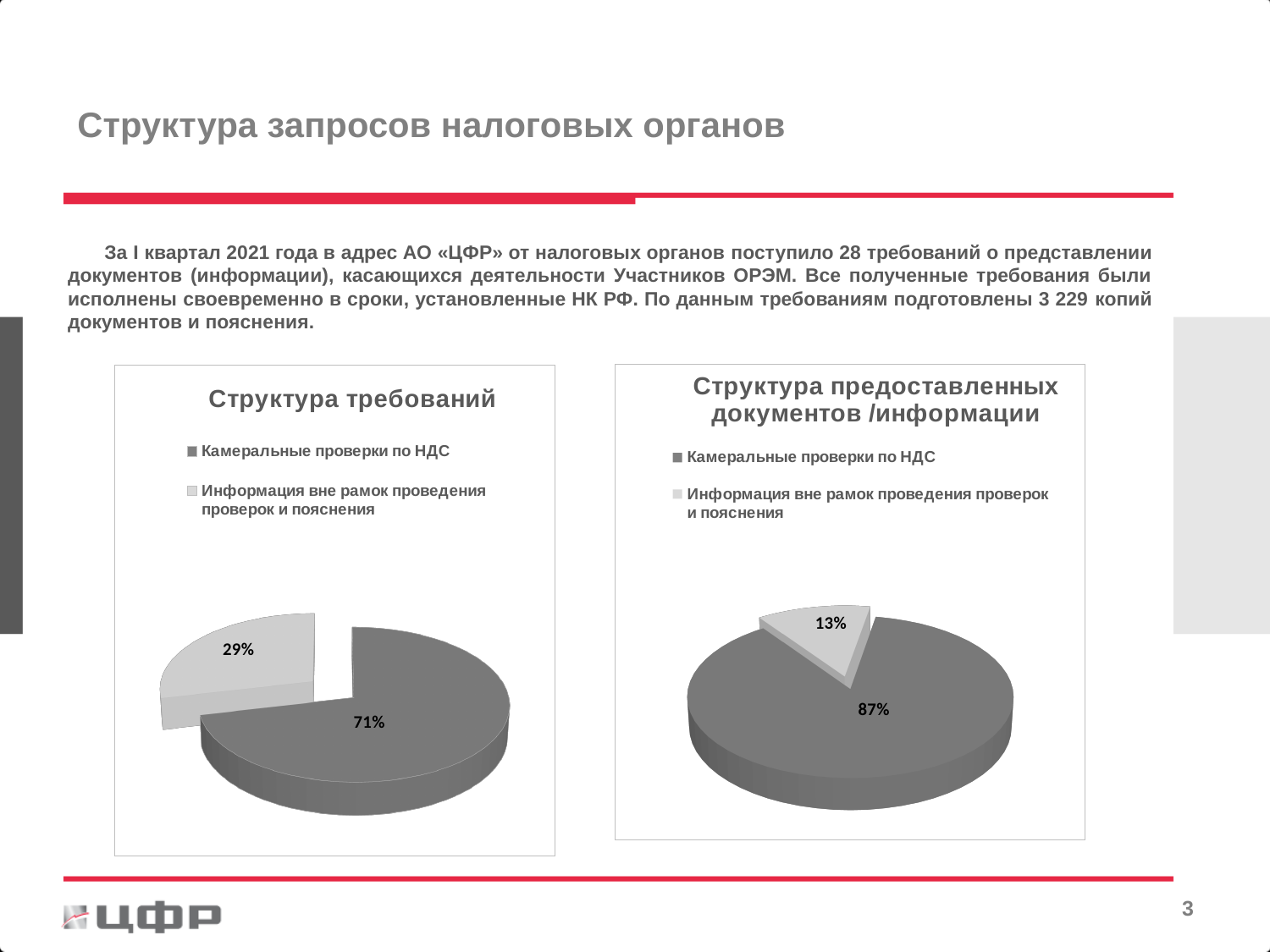
In the "Структура требований" chart, what is the difference between the two slices' percentages? 42% How many entries does the legend of the "Структура предоставленных документов /информации" chart list? 2 How many slices does the "Структура требований" pie chart have? 2 What kind of chart is the "Структура требований" chart? pie chart In the "Структура предоставленных документов /информации" chart, what share is labelled for "Информация вне рамок проведения проверок и пояснения"? 13% In the "Структура предоставленных документов /информации" chart, what share is labelled for "Камеральные проверки по НДС"? 87% In the "Структура требований" chart, which category has the largest slice? Камеральные проверки по НДС Which is larger: the "Камеральные проверки по НДС" share in the "Структура требований" chart or in the "Структура предоставленных документов /информации" chart? Структура предоставленных документов /информации In the "Структура предоставленных документов /информации" chart, what is the difference between the two slices' percentages? 74% In the "Структура требований" chart, what share is labelled for "Камеральные проверки по НДС"? 71% In the "Структура предоставленных документов /информации" chart, which category has the smallest slice? Информация вне рамок проведения проверок и пояснения